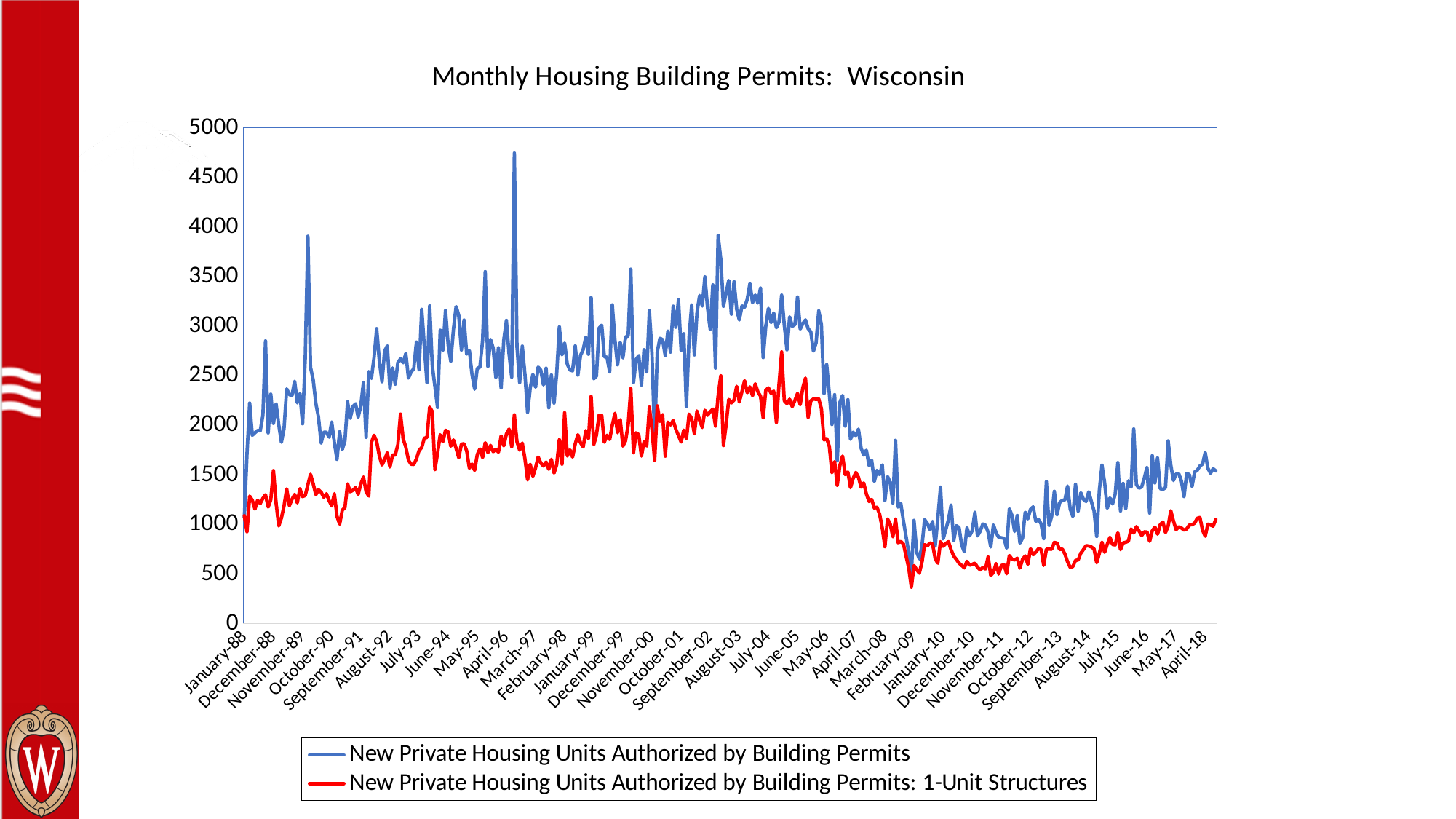
How many series does the legend list? 2 Is the value of the red series around November-11 greater or less than 1000? less What is the title of the chart? Monthly Housing Building Permits: Wisconsin Which series is higher throughout the chart, the blue one or the red one? The blue one (New Private Housing Units Authorized by Building Permits) What kind of chart is shown on the slide? Line chart Is the peak value of the blue series (New Private Housing Units Authorized by Building Permits) around April-96 greater or less than 4500? greater Is the lowest value of the red series (1-Unit Structures) around February-09 greater or less than 500? less Which colour is used for the series 'New Private Housing Units Authorized by Building Permits: 1-Unit Structures'? Red Which series has the lowest point on the chart? New Private Housing Units Authorized by Building Permits: 1-Unit Structures Which series reaches the highest value on the chart? New Private Housing Units Authorized by Building Permits Do the values of both series rise or fall between June-05 and February-09? Fall